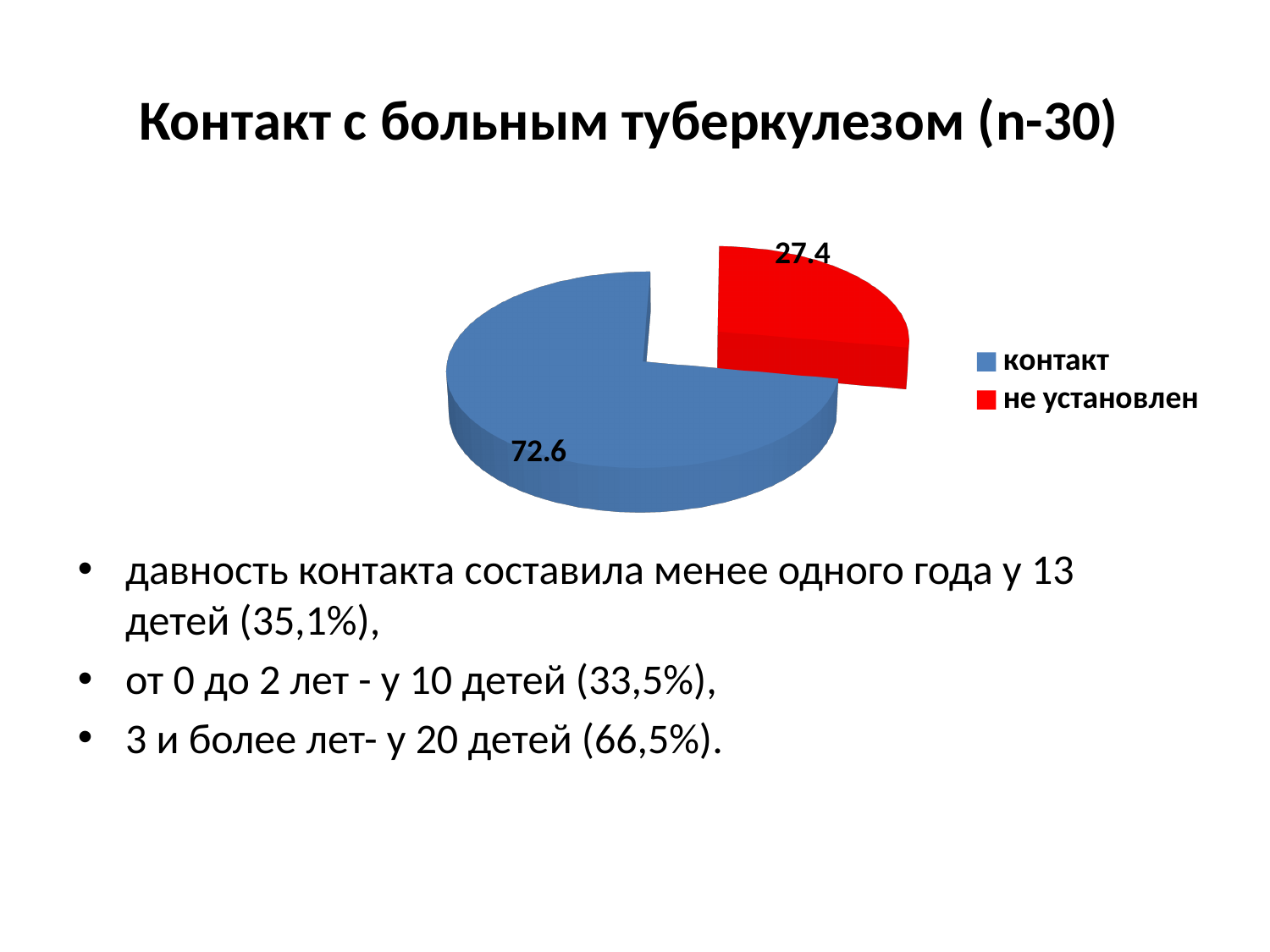
What is the difference between the 'контакт' and 'не установлен' values? 45.2 Which slice is the largest? контакт Which is larger, 'контакт' or 'не установлен'? контакт What is the title of the slide containing the chart? Контакт с больным туберкулезом (n-30) What colour is the 'не установлен' slice? red What is the value for the 'не установлен' slice? 27.4 What type of chart is shown on the slide? pie chart How many entries does the legend list? 2 What is the value for the 'контакт' slice? 72.6 How many slices does the pie chart have? 2 Which slice is the smallest? не установлен